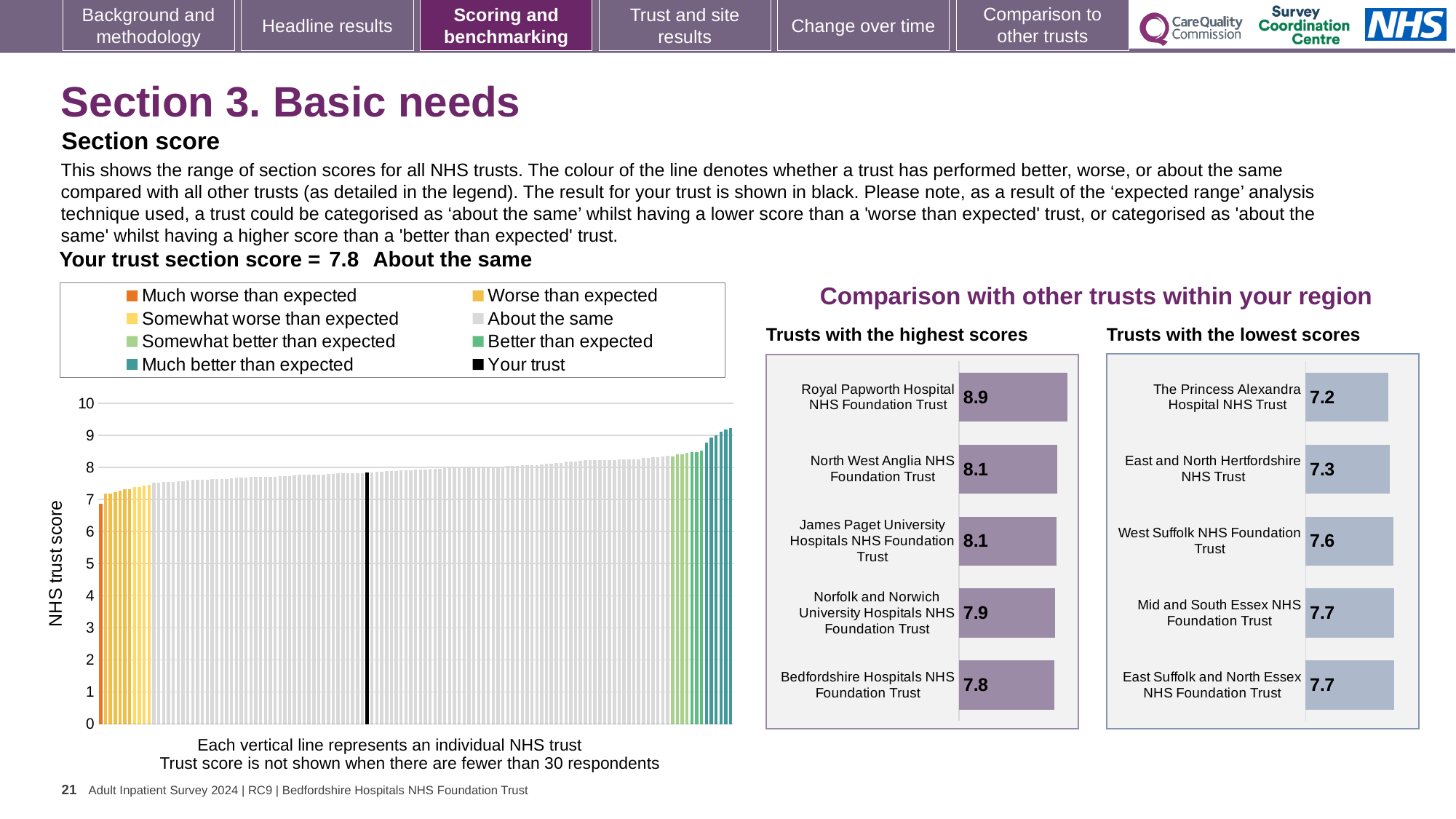
How many entries does the legend of the large NHS trust score chart on the left list? 8 In the 'Trusts with the lowest scores' chart, which trust has the lowest score? The Princess Alexandra Hospital NHS Trust In the 'Trusts with the lowest scores' chart, what is the difference between the scores of West Suffolk NHS Foundation Trust and The Princess Alexandra Hospital NHS Trust? 0.4 In the 'Trusts with the highest scores' chart, what is the score for Royal Papworth Hospital NHS Foundation Trust? 8.9 How many trusts are shown in the 'Trusts with the lowest scores' chart? 5 In the 'Trusts with the highest scores' chart, which trust has the highest score? Royal Papworth Hospital NHS Foundation Trust In the 'Trusts with the lowest scores' chart, what is the score for West Suffolk NHS Foundation Trust? 7.6 In the large NHS trust score chart on the left, do the values rise or fall from left to right? Rise In the large NHS trust score chart on the left, is the value of the tallest bar greater or less than 9? greater What kind of chart is the 'Trusts with the highest scores' chart? Bar chart In the 'Trusts with the highest scores' chart, which has the larger score: North West Anglia NHS Foundation Trust or Norfolk and Norwich University Hospitals NHS Foundation Trust? North West Anglia NHS Foundation Trust In the 'Trusts with the highest scores' chart, what is the difference between the scores of Royal Papworth Hospital NHS Foundation Trust and Bedfordshire Hospitals NHS Foundation Trust? 1.1